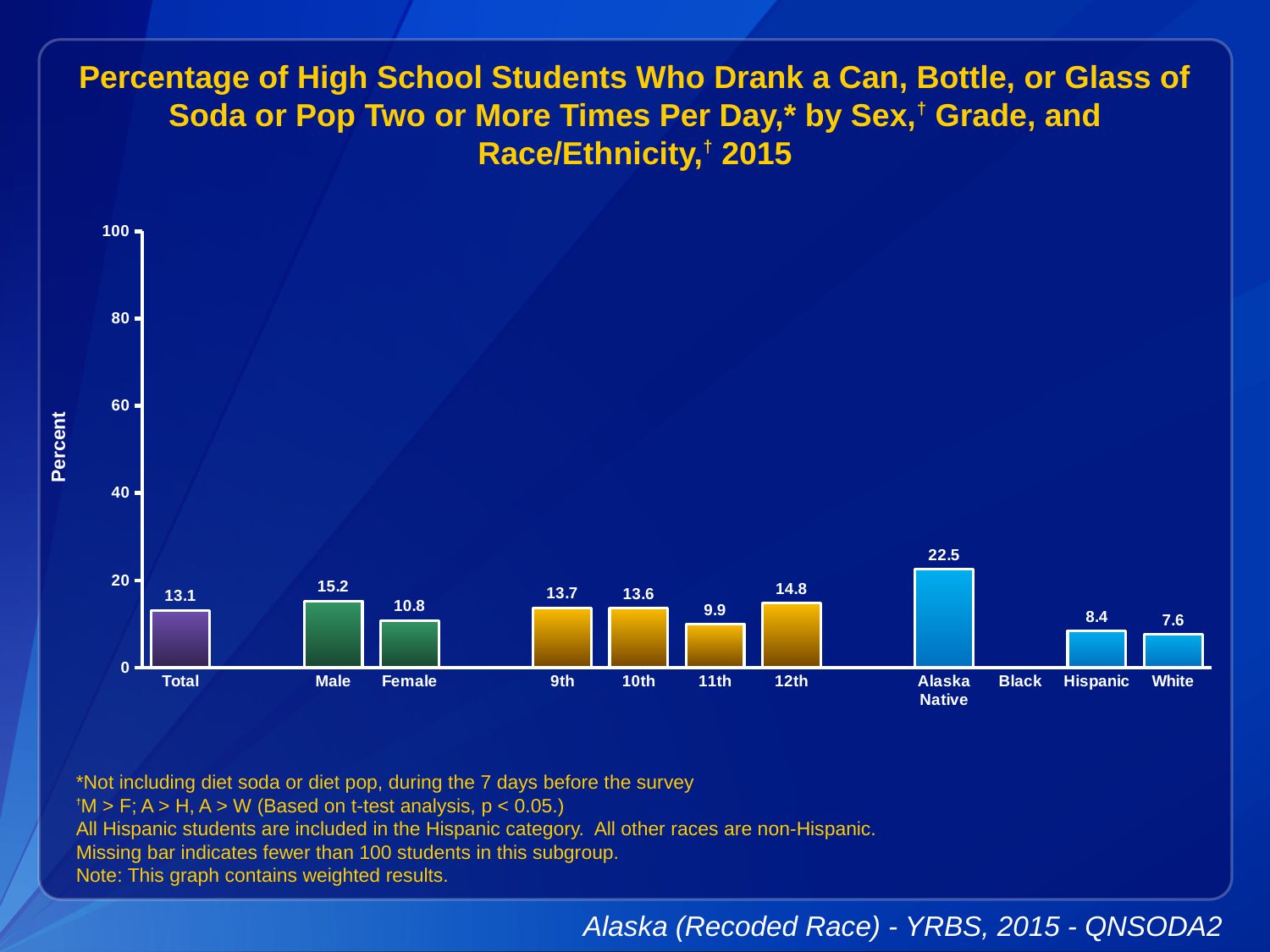
What is the difference between the Male and Female values? 4.4 Which category on the x axis has no bar shown? Black Is the value for Alaska Native greater or less than 20? greater What is the value for Total? 13.1 Which is larger, the value for 12th grade or the value for 9th grade? 12th grade How many categories have a bar plotted on the chart? 10 What is the value for Alaska Native students? 22.5 Which category has the highest value? Alaska Native What is the value for 11th grade? 9.9 What kind of chart is shown? bar chart Which category with a plotted bar has the lowest value? White What percentage of male students drank soda or pop two or more times per day? 15.2